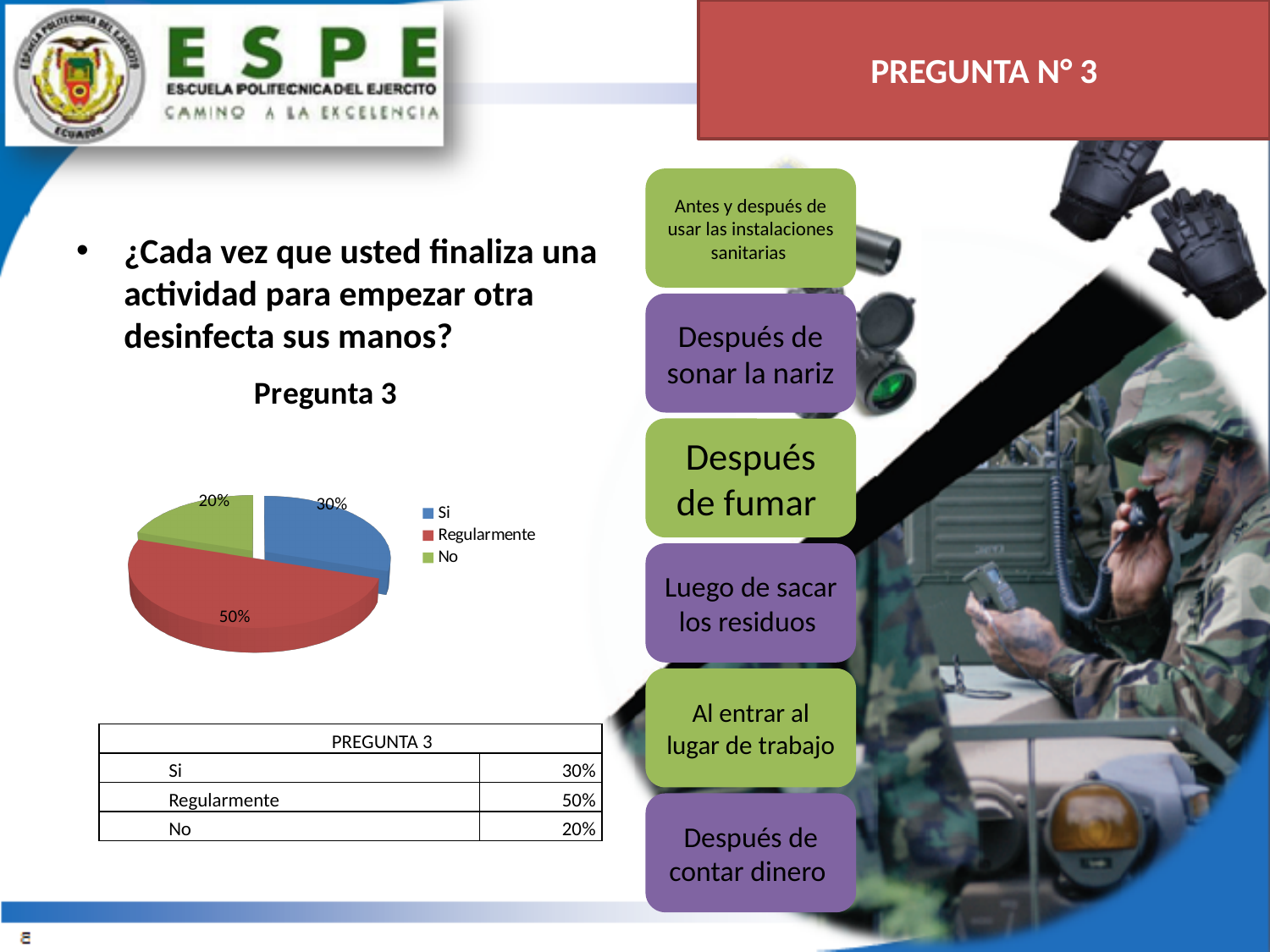
What colour is the "Regularmente" slice in the pie chart? red How many slices does the pie chart have? 3 Which category has the smallest share of the pie? No What is the difference between the "Regularmente" share and the "Si" share? 20% Which is larger, the "Si" slice or the "No" slice? Si How many entries does the legend list? 3 What percentage of the pie does the "Regularmente" slice represent? 50% What type of chart is shown on the slide? pie chart Which category has the largest share of the pie? Regularmente What percentage of the pie does the "Si" slice represent? 30% What percentage of the pie does the "No" slice represent? 20% What is the title of the chart? Pregunta 3